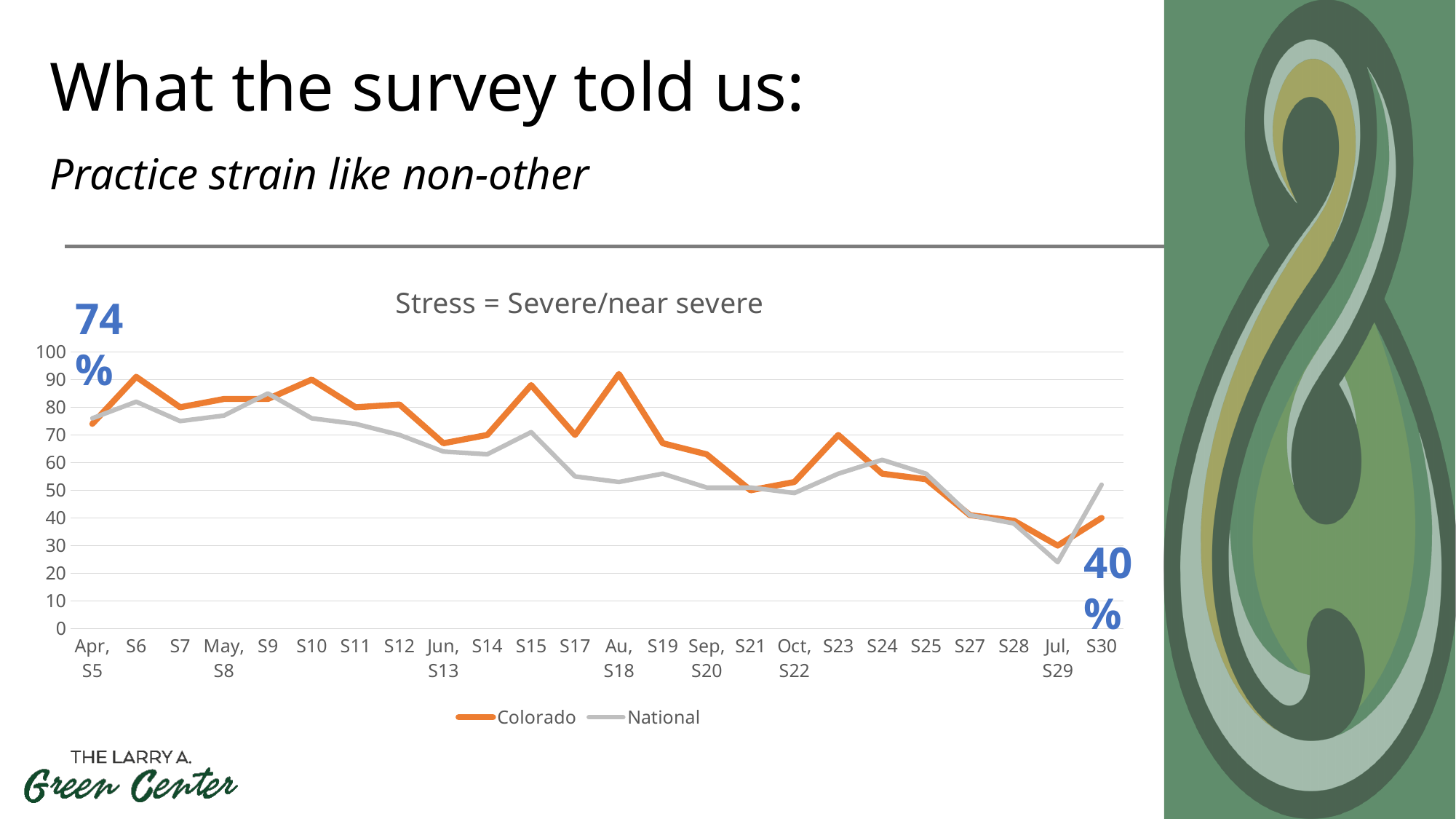
How many series does the legend list? 2 By how much did the Colorado value fall from Apr, S5 to S30? 34 percentage points How many survey points are plotted along the x axis? 24 At which survey point is the Colorado value lowest? Jul, S29 Is the Colorado value at S6 greater or less than 80? greater What is the Colorado value at Apr, S5? 74% What kind of chart is shown on the slide? Line chart Overall, do the values rise or fall from Apr, S5 to S30? Fall Is the National value at Jul, S29 greater or less than 30? less At S15, which series has the higher value, Colorado or National? Colorado At S24, which series has the higher value, Colorado or National? National What is the Colorado value at S30? 40%